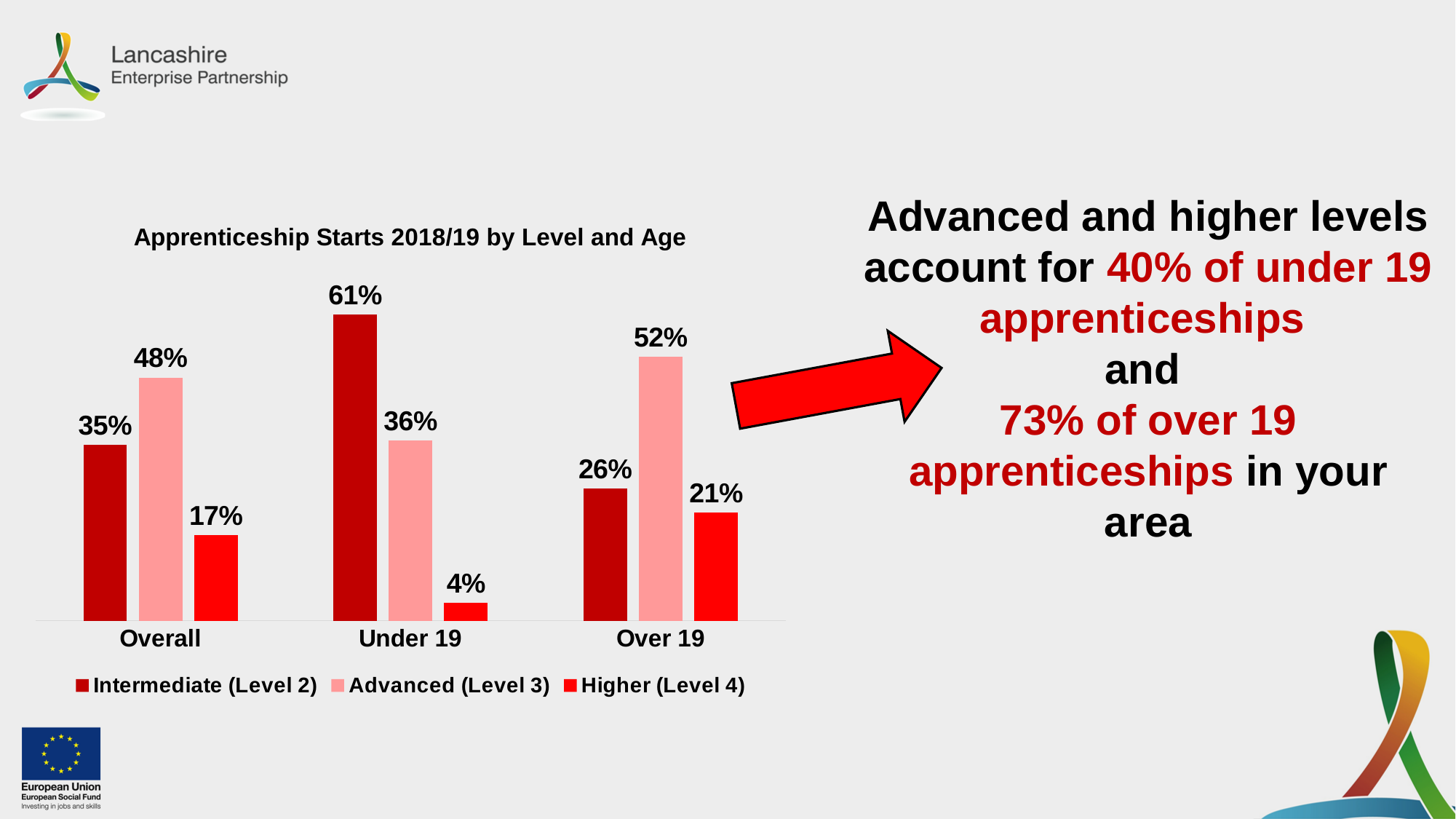
How many series does the legend list? 3 What is the value for Higher (Level 4) in the Over 19 category? 21% How many categories are shown on the x axis? 3 What is the difference between the Advanced (Level 3) values for Over 19 and Under 19? 16% Which category has the highest value for Intermediate (Level 2)? Under 19 What is the value for Intermediate (Level 2) in the Overall category? 35% What is the value for Advanced (Level 3) in the Under 19 category? 36% Which is larger: Intermediate (Level 2) for Under 19 or Advanced (Level 3) for Over 19? Intermediate (Level 2) for Under 19 What is the difference between the Higher (Level 4) values for Over 19 and Under 19? 17% What kind of chart is shown on the slide? Bar chart What is the title of the chart? Apprenticeship Starts 2018/19 by Level and Age Which category has the lowest value for Higher (Level 4)? Under 19